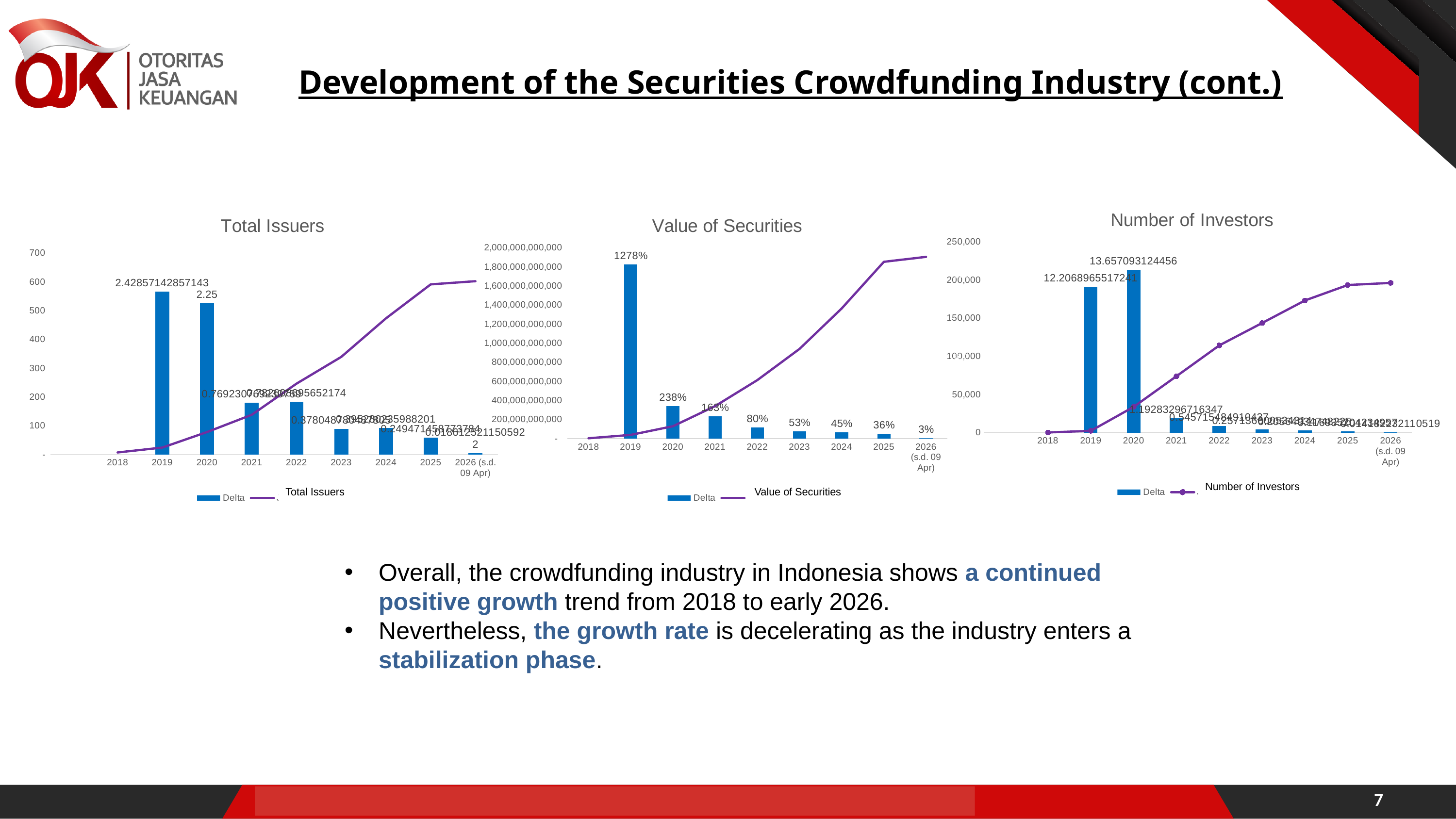
In the Number of Investors chart, is the Number of Investors line value for 2025 greater or less than 150,000? greater In the Number of Investors chart, what is the Delta value for 2020? 13.657093124456 In the Total Issuers chart, which year has the highest Delta value? 2019 How many years are shown on the x axis of the Value of Securities chart? 9 In the Number of Investors chart, does the Number of Investors line rise or fall from 2018 to 2026? rise In the Value of Securities chart, which year has the lowest Delta value? 2026 (s.d. 09 Apr) In the Value of Securities chart, which is larger, the Delta value for 2022 or for 2023? 2022 In the Value of Securities chart, what is the difference between the Delta values for 2019 and 2020? 1040% How many series does the legend of the Total Issuers chart list? 2 In the Total Issuers chart, what is the Delta value for 2020? 2.25 In the Value of Securities chart, what is the Delta value for 2019? 1278% In the Total Issuers chart, is the Total Issuers line value for 2025 greater or less than 500? greater